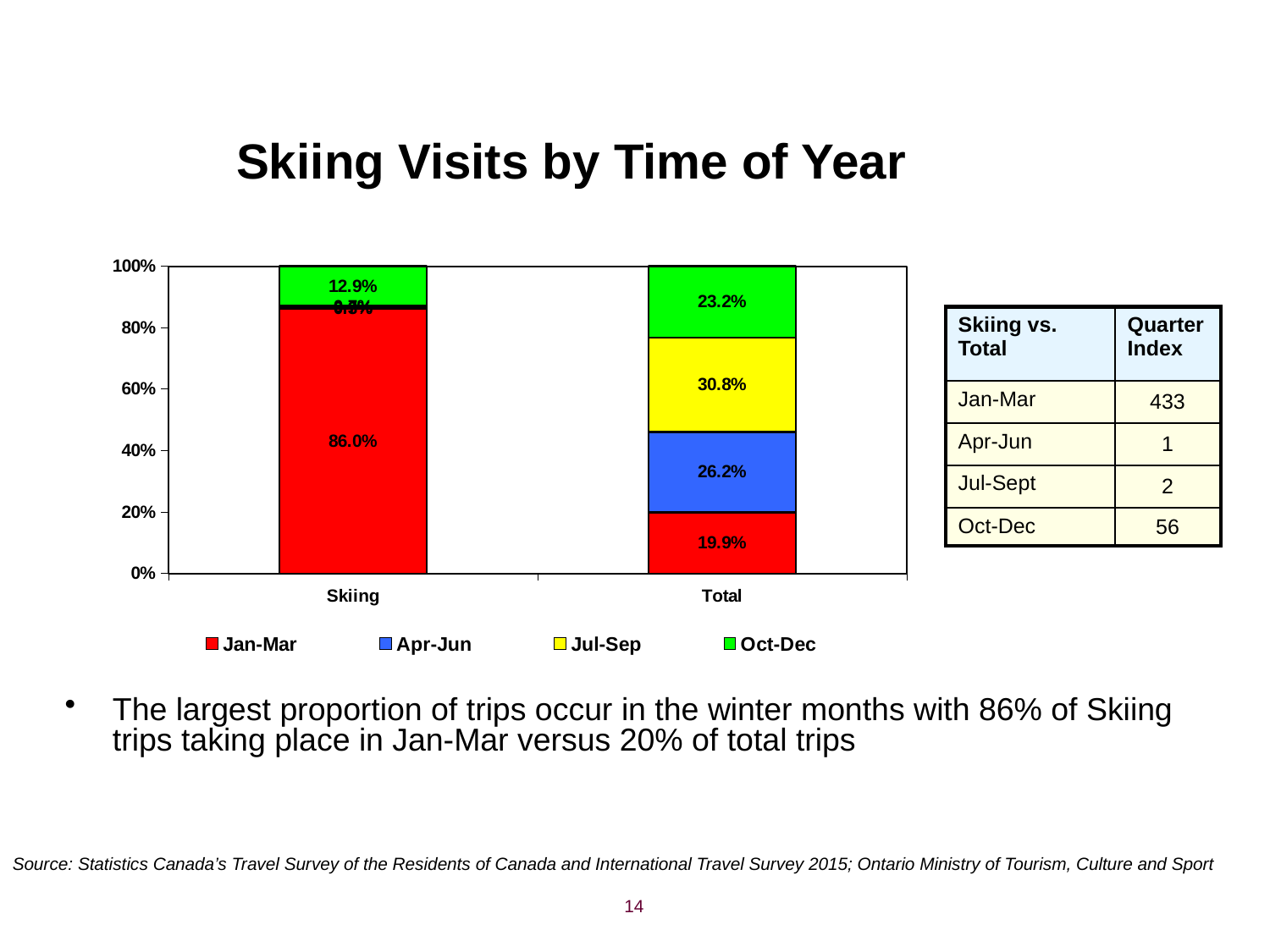
Which quarter has the largest share of Total visits? Jul-Sep What kind of chart is shown on the slide? Stacked bar chart What is the difference between the Jan-Mar share for Skiing and the Jan-Mar share for Total? 66.1% What percentage of Skiing visits occur in Jan-Mar? 86.0% What percentage of Skiing visits occur in Oct-Dec? 12.9% What percentage of Total visits occur in Apr-Jun? 26.2% Which is larger: the Oct-Dec share for Skiing or the Oct-Dec share for Total? Total What percentage of Total visits occur in Jul-Sep? 30.8% What percentage of Total visits occur in Jan-Mar? 19.9% What is the title of the chart? Skiing Visits by Time of Year How many series does the legend list? 4 Which quarter has the smallest share of Total visits? Jan-Mar